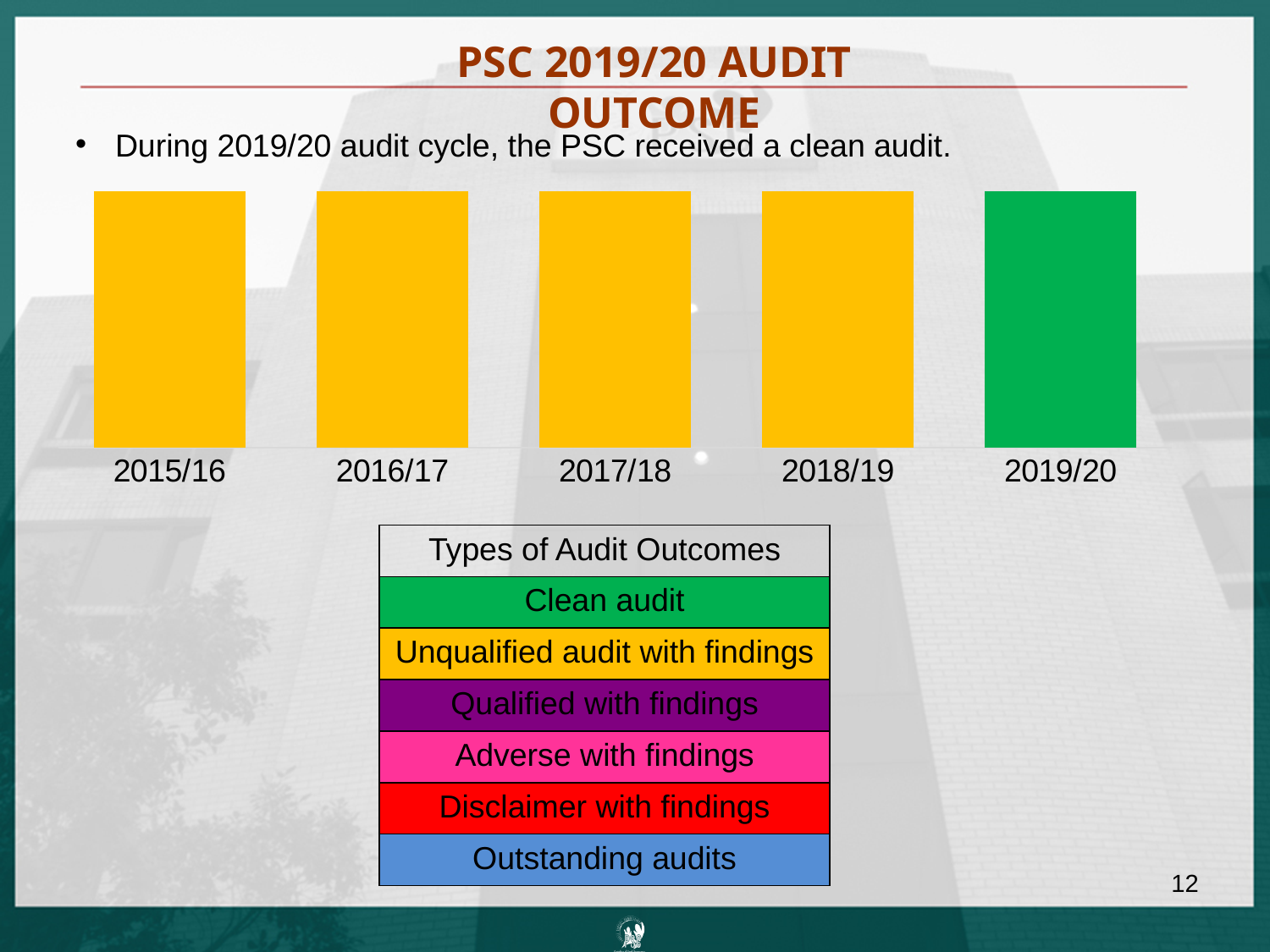
What is the first financial year shown on the x axis? 2015/16 What is the title of the legend table below the chart? Types of Audit Outcomes How many financial years are shown as bars on the chart? 5 Which financial year is the only one shown with a clean audit outcome? 2019/20 According to the legend, what audit outcome does the colour of the 2018/19 bar represent? Unqualified audit with findings According to the legend, what audit outcome does the colour of the 2019/20 bar represent? Clean audit What kind of chart is shown on the slide? bar chart How many of the five years shown have an unqualified audit with findings outcome? 4 According to the legend, what audit outcome does the colour of the 2015/16 bar represent? Unqualified audit with findings What colour represents a clean audit in the legend? green How many types of audit outcomes are listed in the legend table? 6